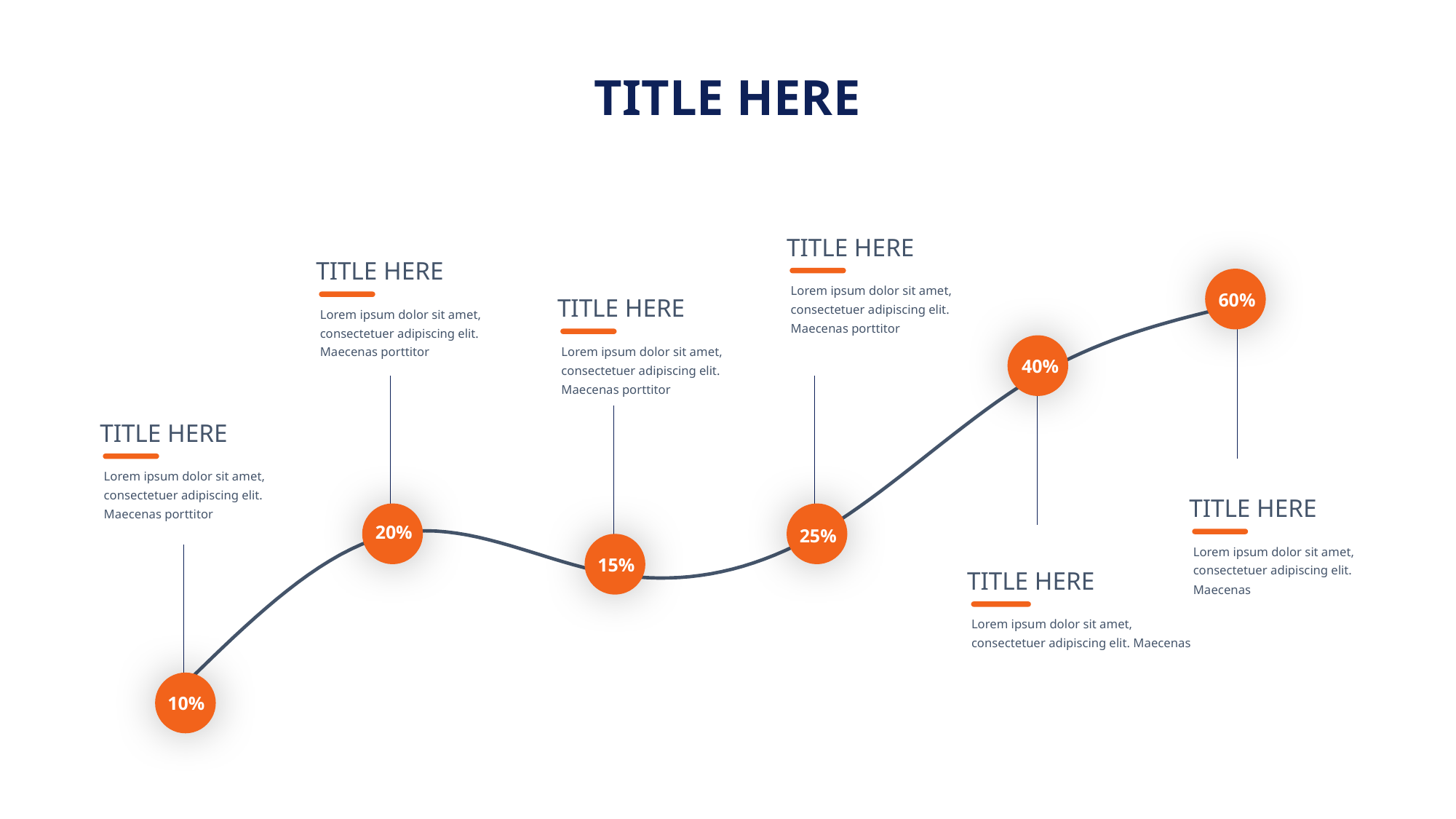
What is the value of the first (leftmost) point on the line? 10% What kind of chart is shown on the slide? line chart How many data points are plotted on the line? 6 Which point has the highest value on the line? 60% Does the line rise or fall between the fourth point and the sixth point? rise What colour are the data point markers on the line? orange What is the difference between the last point (60%) and the first point (10%)? 50% What is the difference between the second point (20%) and the third point (15%)? 5% What is the value of the third point from the left on the line? 15% What is the value of the last (rightmost) point on the line? 60% Which point has the lowest value on the line? 10% Which is larger, the second point or the third point on the line? the second point (20%)